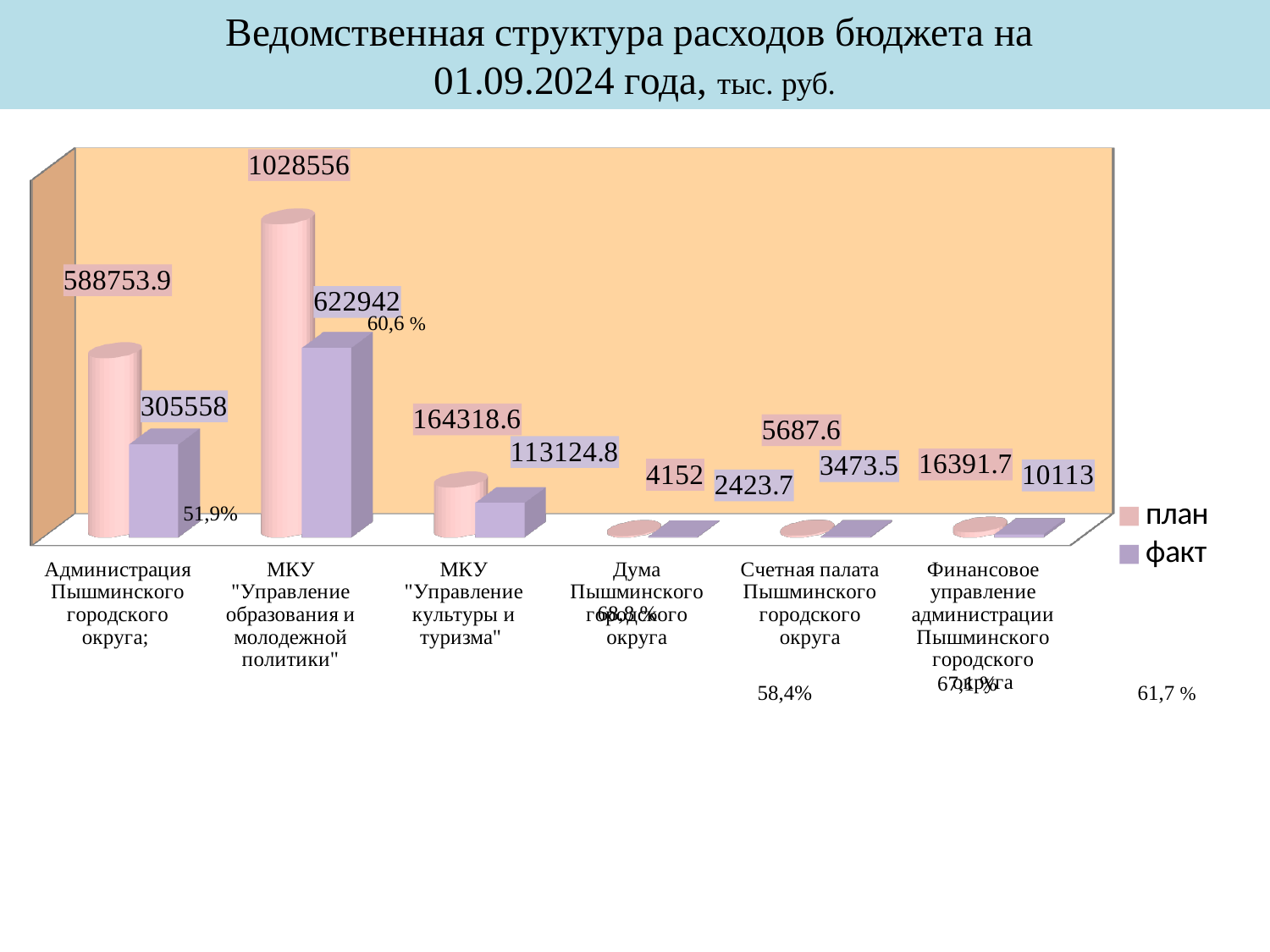
Which is larger: the план value for Счетная палата Пышминского городского округа or the план value for Дума Пышминского городского округа? Счетная палата Пышминского городского округа How many categories are shown on the x axis of the chart? 6 What is the факт value for МКУ "Управление культуры и туризма"? 113124.8 What is the difference between the план and факт values for МКУ "Управление образования и молодежной политики"? 405614 Which category has the lowest факт value? Дума Пышминского городского округа What is the план (plan) value for МКУ "Управление образования и молодежной политики"? 1028556 What is the difference between the план and факт values for Счетная палата Пышминского городского округа? 2214.1 What is the план value for Дума Пышминского городского округа? 4152 What is the факт (actual) value for Администрация Пышминского городского округа? 305558 How many series does the legend list? 2 What is the факт value for Финансовое управление администрации Пышминского городского округа? 10113 Which category has the highest план value? МКУ "Управление образования и молодежной политики"